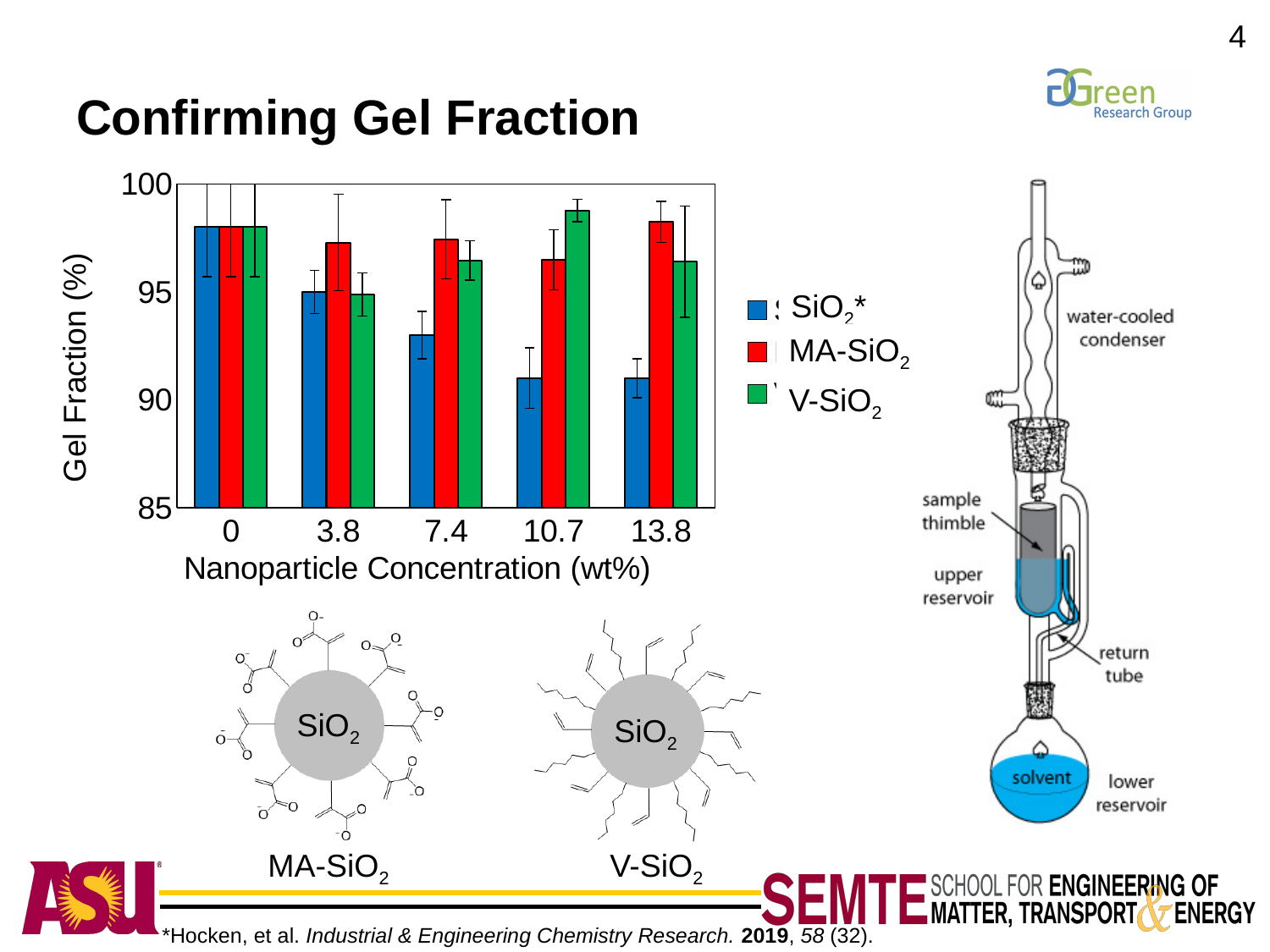
Is the gel fraction for SiO2* at 7.4 wt% greater or less than 95? less What kind of chart is shown on the slide? bar chart Is the gel fraction for MA-SiO2 at 7.4 wt% greater or less than 95? greater What is the label of the x axis of the chart? Nanoparticle Concentration (wt%) How many nanoparticle concentration categories are shown on the x axis of the chart? 5 At 13.8 wt%, which series has the lowest gel fraction? SiO2* At 10.7 wt%, which series has the highest gel fraction? V-SiO2 At 7.4 wt%, which has the larger gel fraction, SiO2* or MA-SiO2? MA-SiO2 Does the gel fraction for the SiO2* series rise or fall as nanoparticle concentration increases along the x axis? fall What is the label of the y axis of the chart? Gel Fraction (%) How many series does the chart's legend list? 3 Is the gel fraction for SiO2* at 10.7 wt% greater or less than 95? less